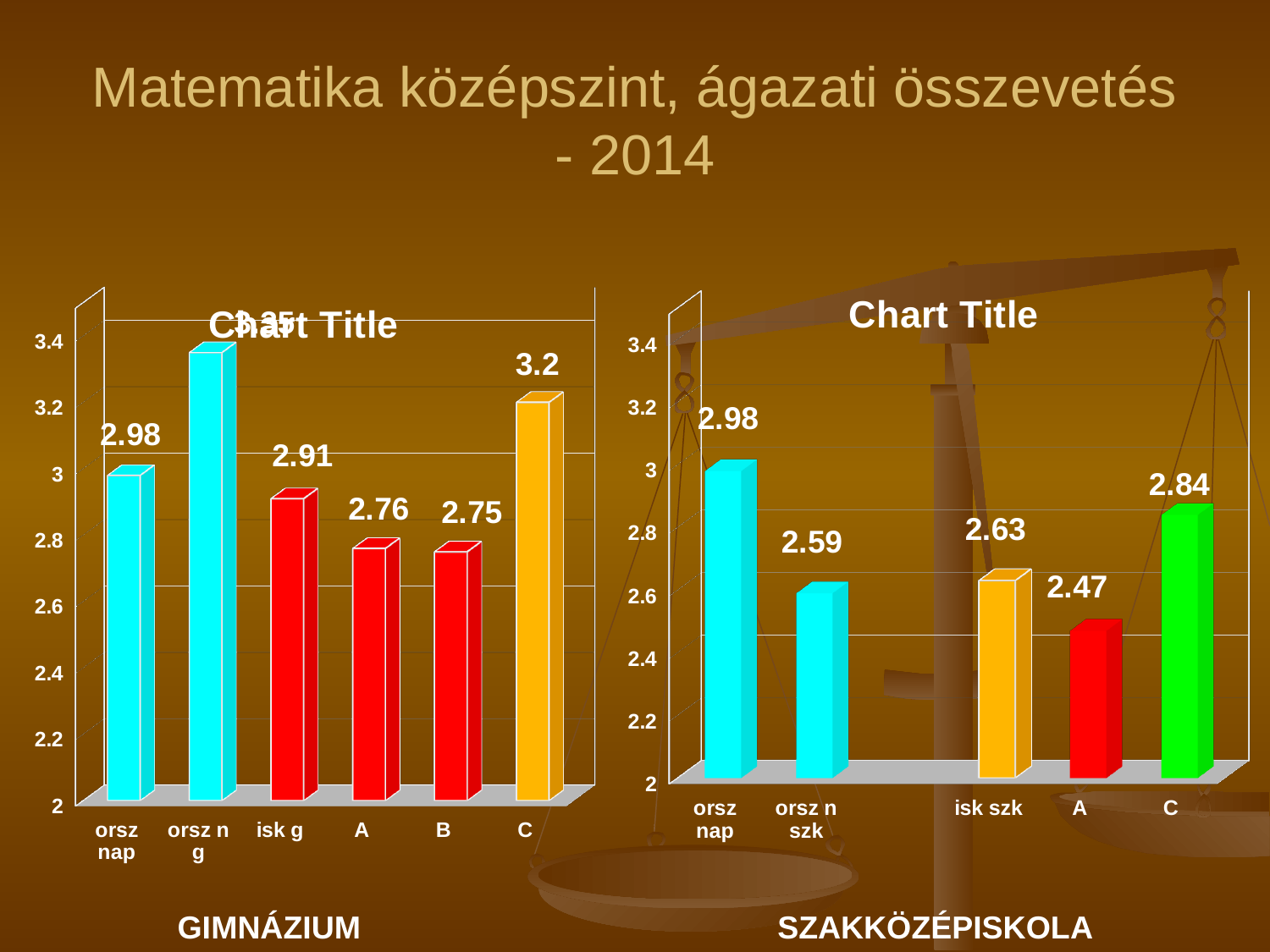
What kind of chart is the left chart (GIMNÁZIUM)? bar chart In the right chart (SZAKKÖZÉPISKOLA), which category has the lowest value? A In the left chart (GIMNÁZIUM), which category has the highest bar? orsz n g In the right chart (SZAKKÖZÉPISKOLA), which category has the highest value? orsz nap In the left chart (GIMNÁZIUM), what is the difference between the values for C and isk g? 0.29 In the right chart (SZAKKÖZÉPISKOLA), which is larger, the value for isk szk or the value for C? C In the left chart (GIMNÁZIUM), what is the value for isk g? 2.91 In the right chart (SZAKKÖZÉPISKOLA), what is the difference between the values for orsz nap and A? 0.51 In the right chart (SZAKKÖZÉPISKOLA), what is the value for orsz n szk? 2.59 How many categories are labelled on the x axis of the right chart (SZAKKÖZÉPISKOLA)? 5 In the left chart (GIMNÁZIUM), what is the value for C? 3.2 In the left chart (GIMNÁZIUM), is the value for orsz n g greater or less than 3.2? greater